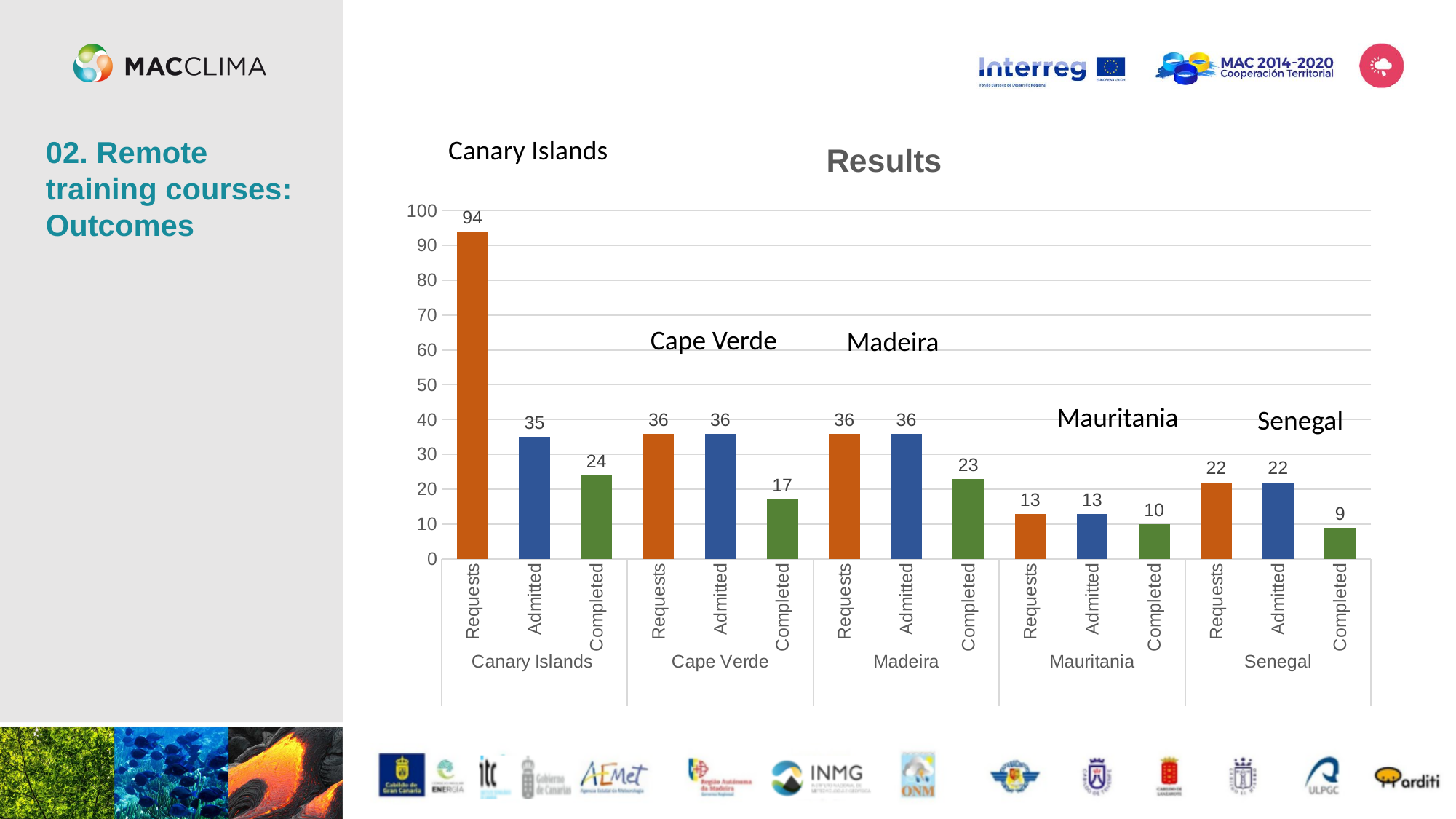
What is the difference between Requests and Completed in the Canary Islands? 70 How many regions are shown on the x axis? 5 What is the value for Completed in Senegal? 9 What is the difference between Admitted and Completed in Madeira? 13 Which is larger, Completed in the Canary Islands or Completed in Madeira? Completed in the Canary Islands What kind of chart is shown? Bar chart What is the value for Completed in Cape Verde? 17 What is the value for Requests in the Canary Islands? 94 What is the value for Admitted in Mauritania? 13 What is the title of the chart? Results Which region has the lowest number of Completed? Senegal Which region has the highest number of Requests? Canary Islands